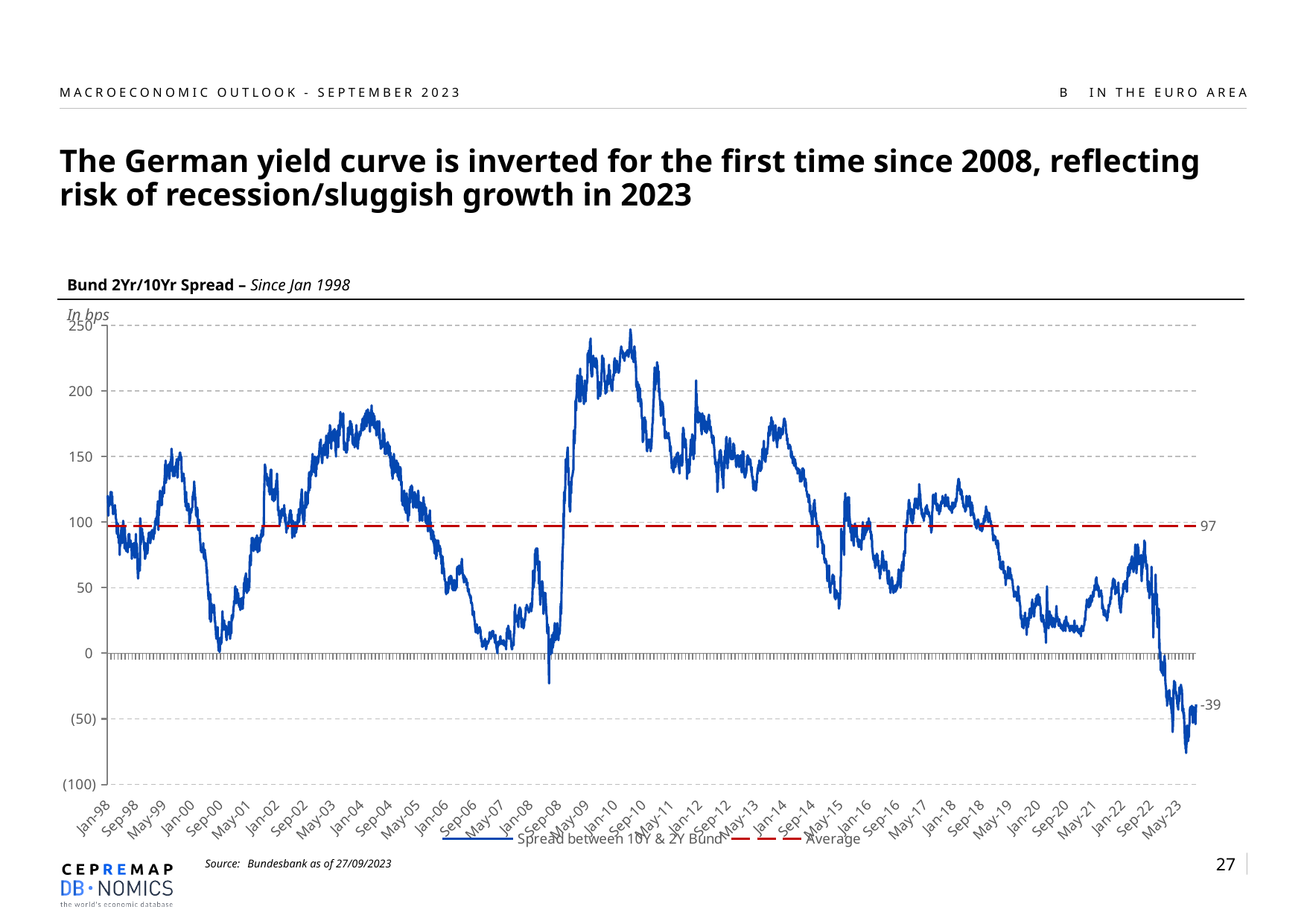
Does the spread rise or fall between Sep-22 and May-23? fall Is the spread value around May-09 greater or less than 150? greater Which series is drawn as a red dashed line? Average Which is larger, the Average line value or the latest spread value? Average How many series does the legend list? 2 Is the highest value reached by the spread line greater or less than 200? greater Is the spread value around Sep-00 greater or less than 50? less What is the value of the Average line shown on the chart? 97 What is the latest value of the spread between 10Y & 2Y Bund labelled at the end of the line? -39 What is the difference between the Average (97) and the latest spread value (-39)? 136 What kind of chart is shown on the slide? line chart What is the title of the chart? Bund 2Yr/10Yr Spread – Since Jan 1998